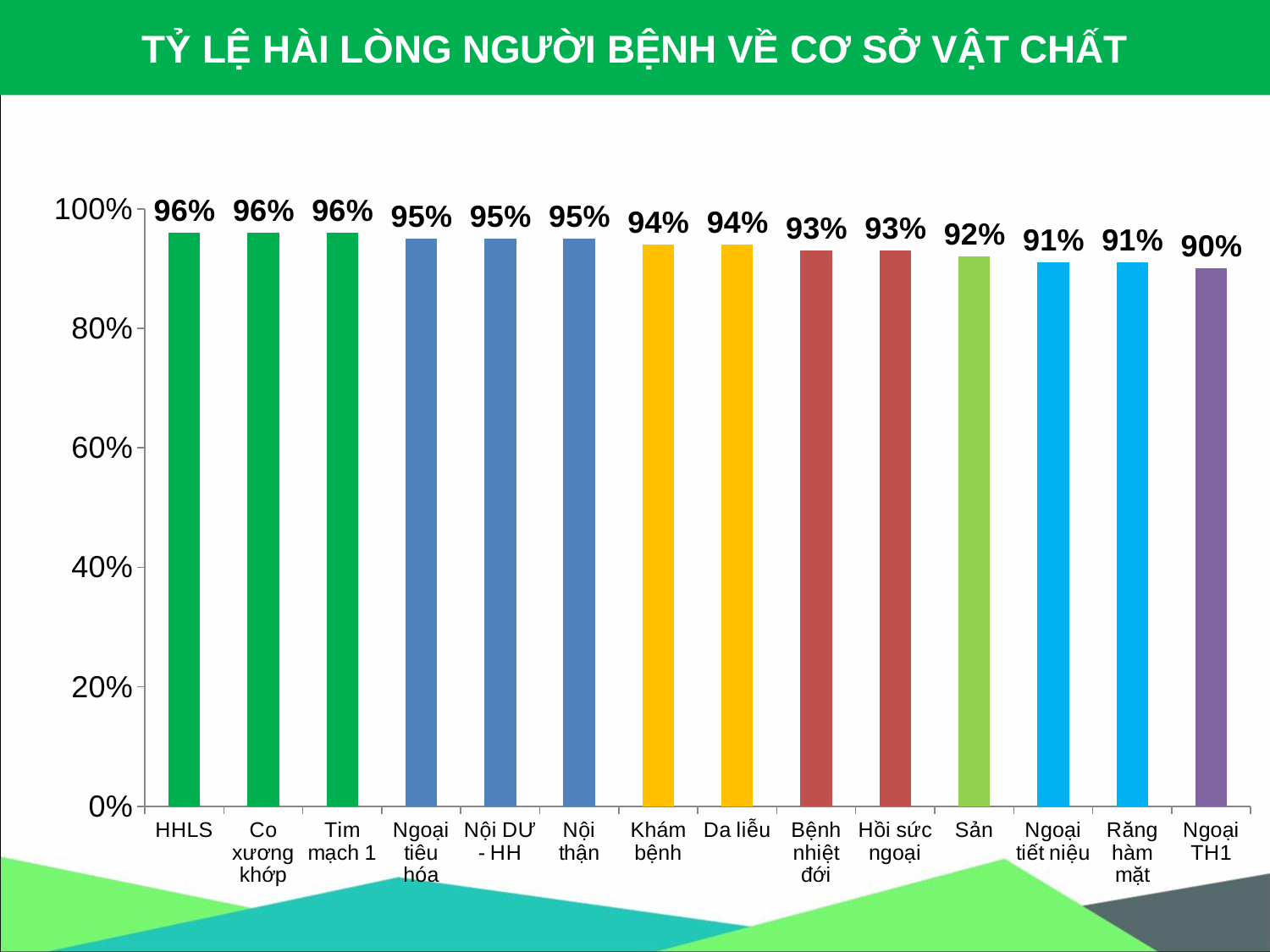
Which is larger, the value for Tim mạch 1 or the value for Da liễu? Tim mạch 1 What is the value for Hồi sức ngoại? 93% Do the values rise or fall from left to right along the x axis? Fall What is the difference between the values for Nội thận and Răng hàm mặt? 4% What is the difference between the values for HHLS and Ngoại TH1? 6% What kind of chart is shown on the slide? Bar chart What is the value for Ngoại tiêu hóa? 95% How many categories are shown in the chart? 14 Which category has the lowest value? Ngoại TH1 What is the value for Khám bệnh? 94% Is the value for Bệnh nhiệt đới greater or less than 80%? greater What is the value for Sản? 92%